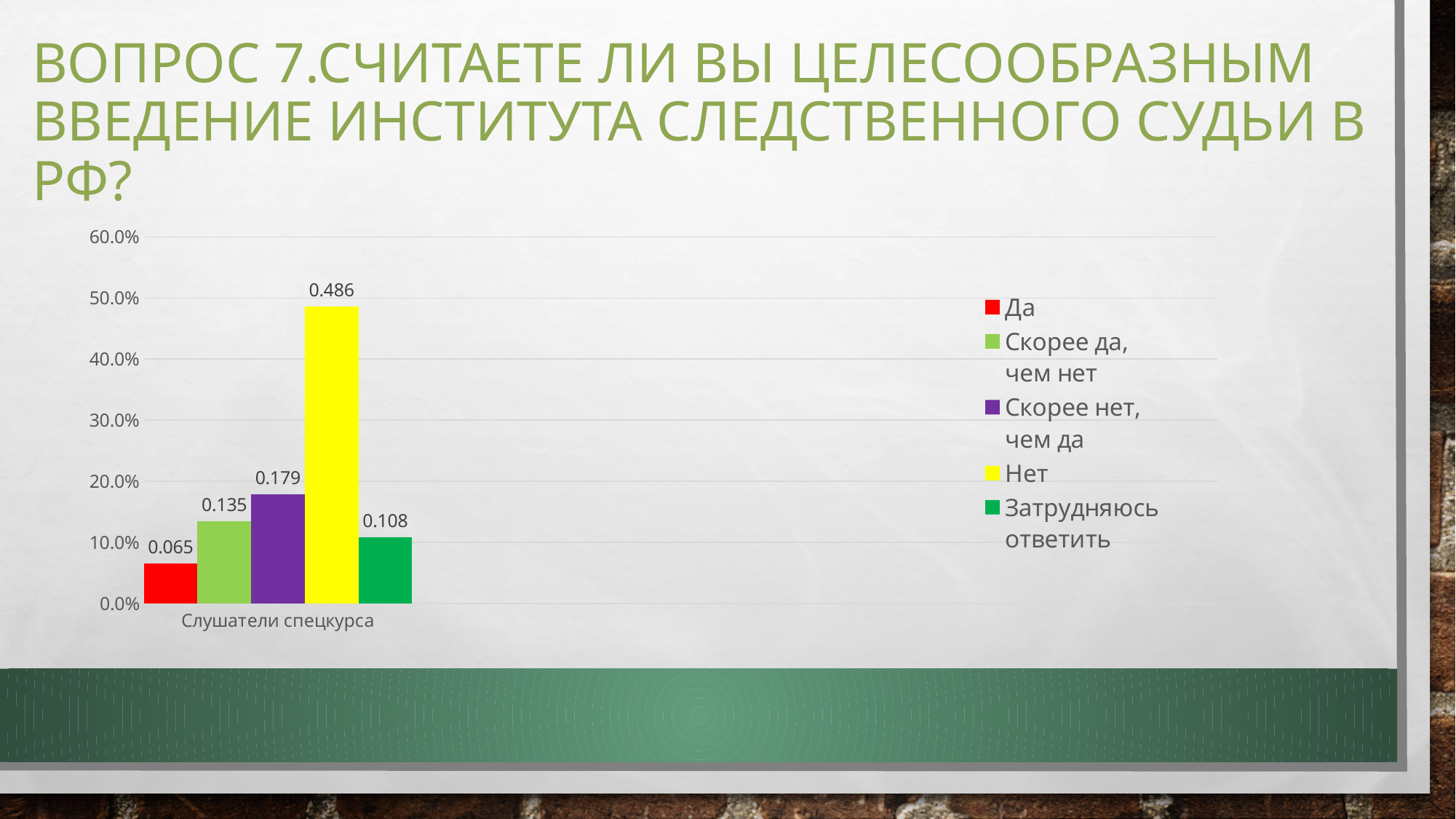
Which answer option has the lowest value? Да Which answer option has the highest value? Нет Which is larger, the value for "Скорее да, чем нет" or the value for "Затрудняюсь ответить"? Скорее да, чем нет What is the value for "Скорее да, чем нет"? 0.135 What is the difference between the values for "Нет" and "Скорее нет, чем да"? 0.307 What is the value for "Нет" for Слушатели спецкурса? 0.486 What is the value for "Да" for Слушатели спецкурса? 0.065 What kind of chart is shown on the slide? bar chart What colour is the bar for "Нет"? yellow Is the value for "Скорее нет, чем да" greater or less than 20.0%? less What is the value for "Затрудняюсь ответить"? 0.108 How many series does the legend list? 5